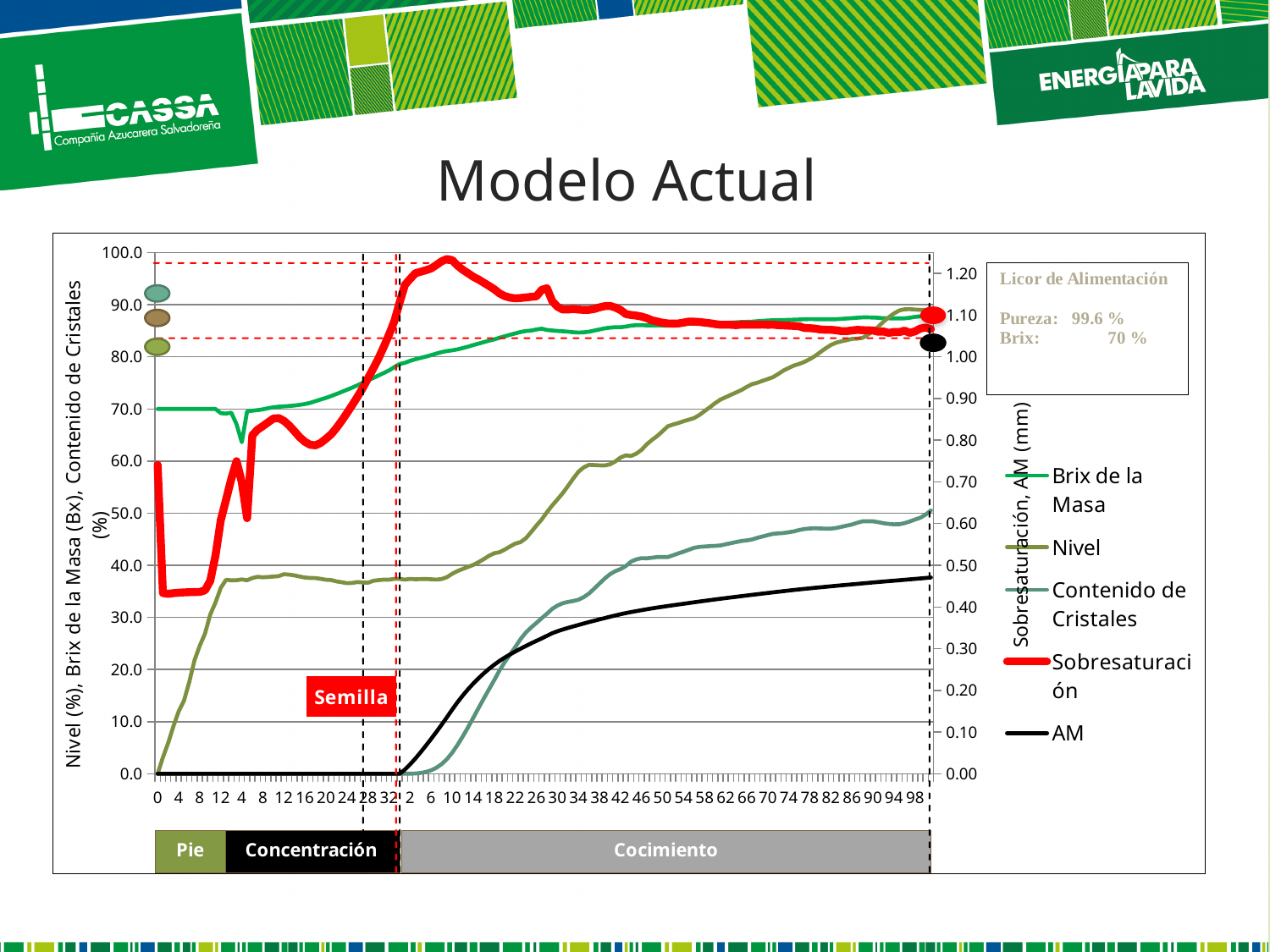
What Pureza value is given for the Licor de Alimentación? 99.6 % Is the value for Nivel at the end of the Cocimiento phase greater or less than 80? greater Does the Nivel series rise or fall along the x axis during the Cocimiento phase? rise Does the AM series rise or fall along the x axis during the Cocimiento phase? rise What kind of chart is shown on the slide? line chart What are the three phase labels shown below the x axis? Pie, Concentración, Cocimiento Is the value for Brix de la Masa at the start of the Pie phase greater or less than 60? greater How many series does the legend list? 5 Is the peak value of Sobresaturación greater or less than 1.10? greater At the end of the Cocimiento phase, which is higher on the left axis: Nivel or Contenido de Cristales? Nivel Does the Contenido de Cristales series rise or fall along the x axis during the Cocimiento phase? rise